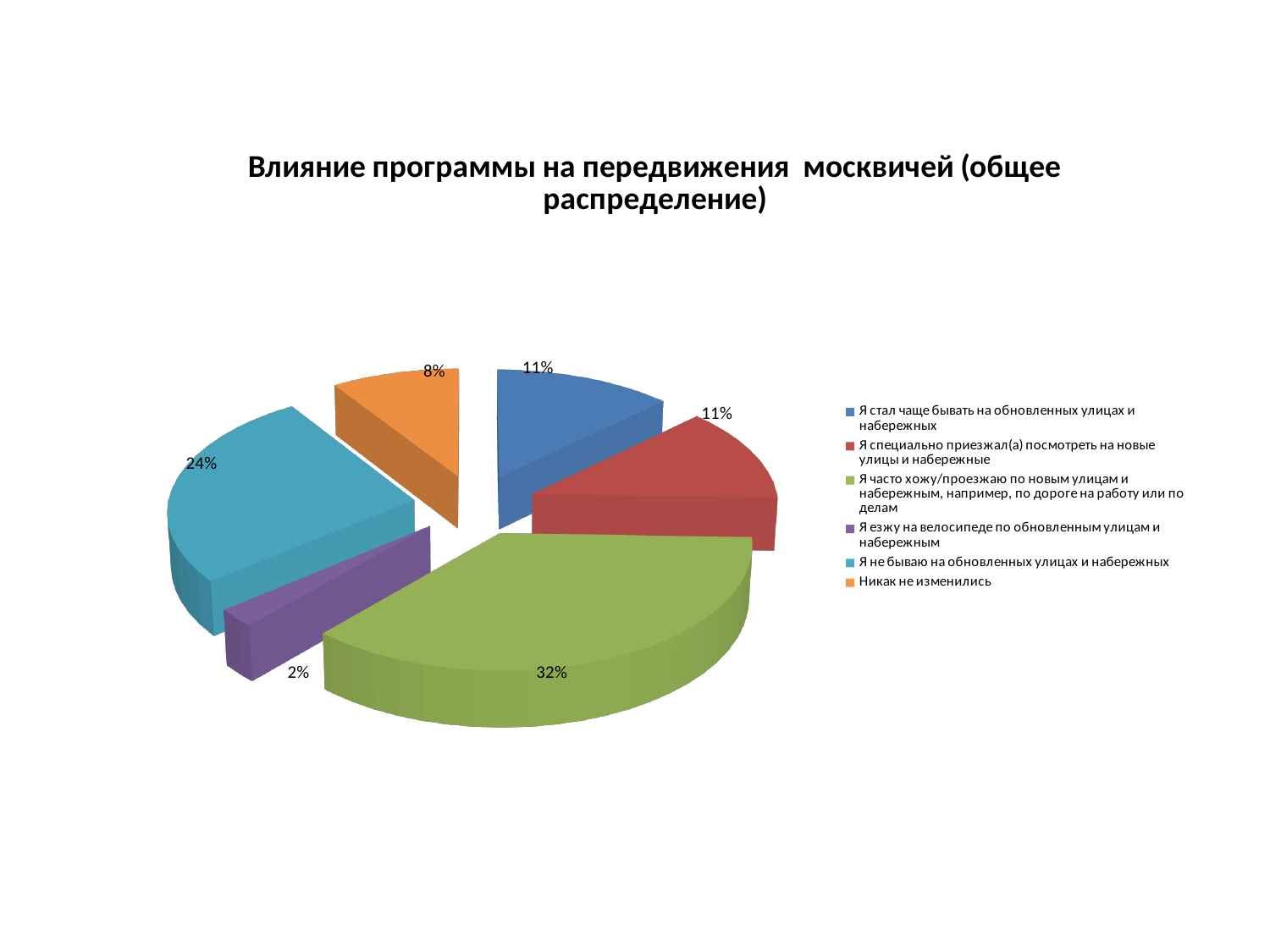
What share of the pie is labelled "Я езжу на велосипеде по обновленным улицам и набережным"? 2% What share of the pie is labelled "Никак не изменились"? 8% What kind of chart is shown on the slide? Pie chart Which is larger: the share for "Я не бываю на обновленных улицах и набережных" or the share for "Я специально приезжал(а) посмотреть на новые улицы и набережные"? Я не бываю на обновленных улицах и набережных What is the difference in percentage points between the "Я не бываю на обновленных улицах и набережных" slice and the "Никак не изменились" slice? 16 What is the title of the chart? Влияние программы на передвижения москвичей (общее распределение) What share of the pie is labelled "Я стал чаще бывать на обновленных улицах и набережных"? 11% What share of the pie is labelled "Я часто хожу/проезжаю по новым улицам и набережным, например, по дороге на работу или по делам"? 32% Which category has the smallest share of the pie? Я езжу на велосипеде по обновленным улицам и набережным How many categories does the legend list? 6 Which category has the largest share of the pie? Я часто хожу/проезжаю по новым улицам и набережным, например, по дороге на работу или по делам What share of the pie is labelled "Я не бываю на обновленных улицах и набережных"? 24%